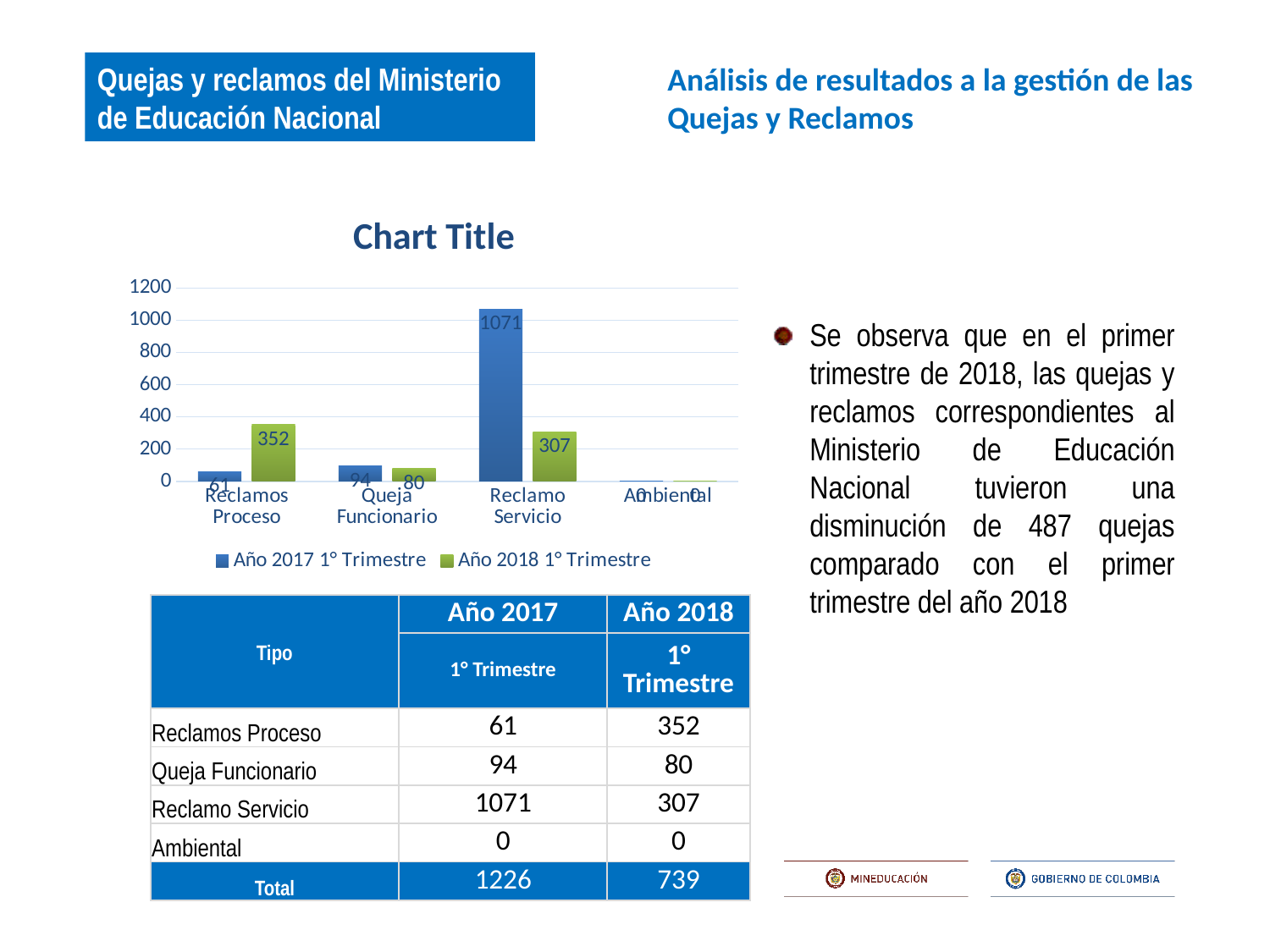
For Reclamos Proceso, which series has the larger value: Año 2017 1° Trimestre or Año 2018 1° Trimestre? Año 2018 1° Trimestre How many categories are shown on the x axis of the chart? 4 What is the title of the chart? Chart Title What is the value for Queja Funcionario in the Año 2017 1° Trimestre series? 94 Which category has the lowest value in the Año 2018 1° Trimestre series? Ambiental What is the difference between the Año 2017 1° Trimestre and Año 2018 1° Trimestre values for Reclamo Servicio? 764 What kind of chart is shown on the slide? bar chart Which category has the highest value in the Año 2017 1° Trimestre series? Reclamo Servicio What is the value for Reclamo Servicio in the Año 2017 1° Trimestre series? 1071 What is the value for Reclamos Proceso in the Año 2018 1° Trimestre series? 352 How many series does the chart legend list? 2 Is the value for Reclamo Servicio in the Año 2017 1° Trimestre series greater or less than 1000? greater